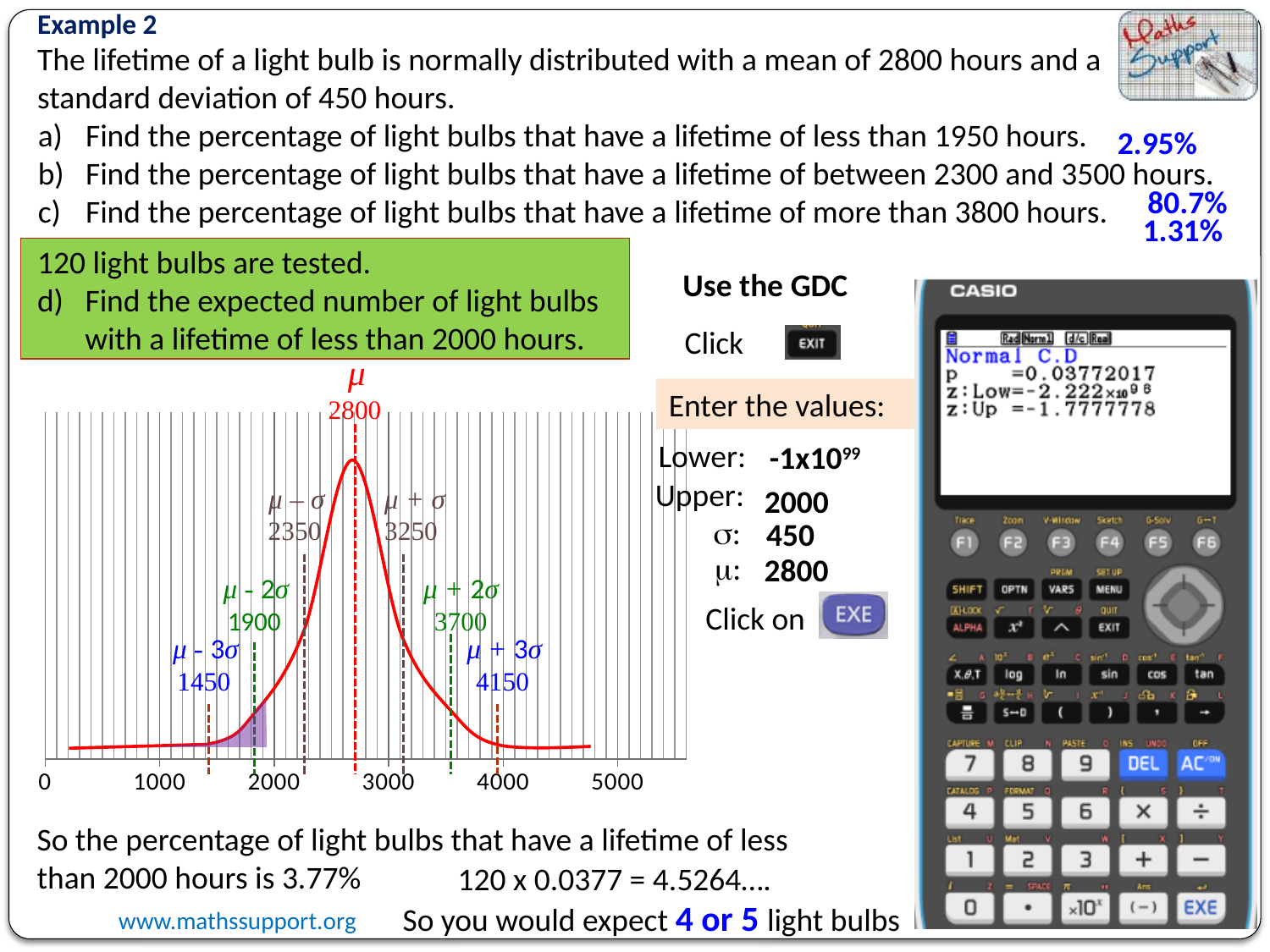
What value is labelled at μ − 2σ on the chart? 1900 How many labelled vertical dashed lines (μ, μ ± σ, μ ± 2σ, μ ± 3σ) are marked on the chart? 7 What colour is the normal distribution curve on the chart? red What is the difference between the values labelled μ + σ and μ − σ on the chart? 900 What is the difference between the values labelled μ + 3σ and μ − 3σ on the chart? 2700 At which labelled x value does the curve reach its highest point? 2800 How many tick labels are shown on the x axis of the chart? 6 What value is labelled at μ + 3σ on the chart? 4150 Is the value labelled μ + 2σ greater or less than 4000? less What kind of chart is shown on the slide? line chart (normal distribution curve) What value is labelled at the mean μ on the chart? 2800 What value is labelled at μ + σ on the chart? 3250